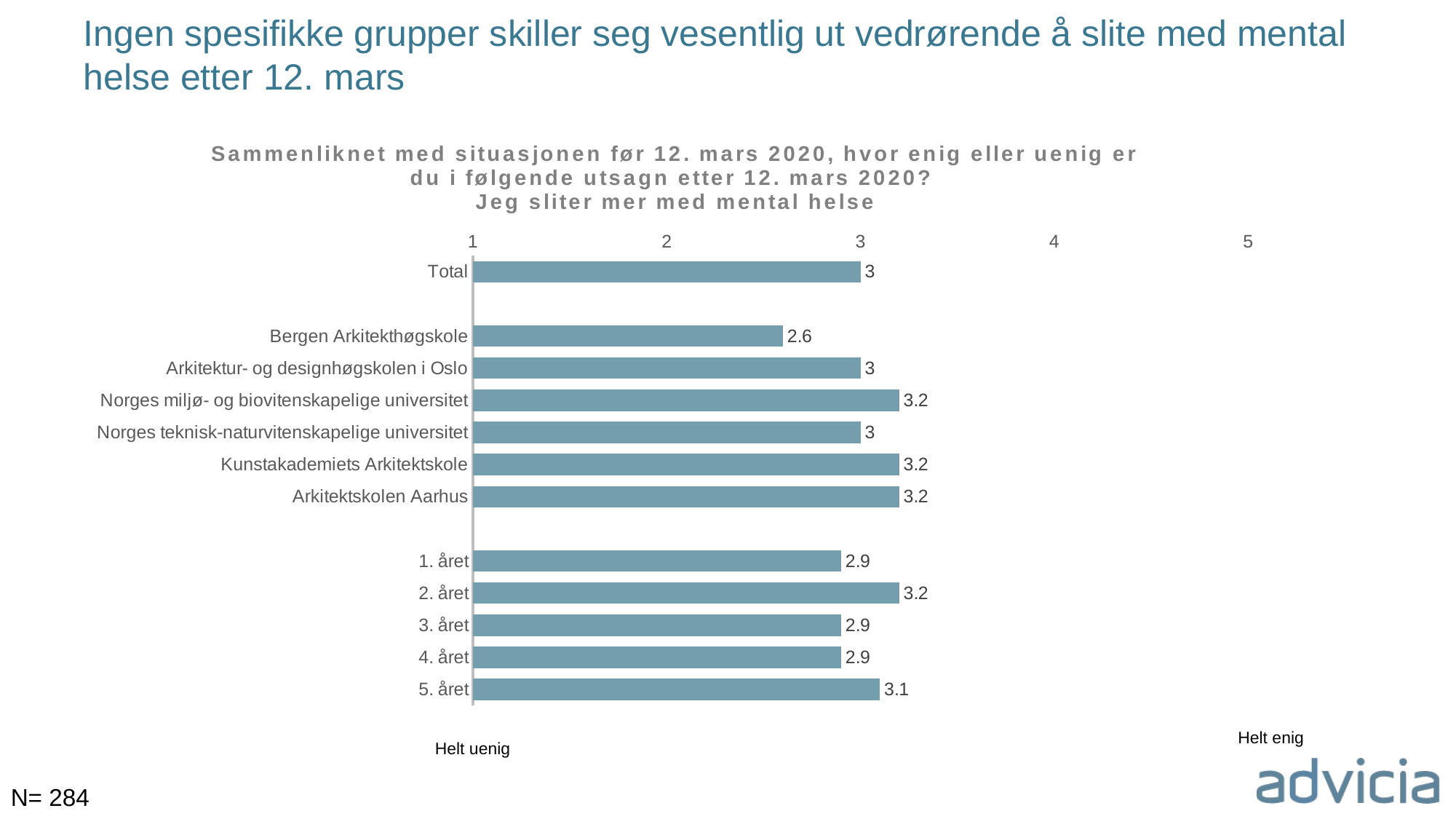
Is the value for Arkitektskolen Aarhus greater or less than 4? less Which category has the lowest value? Bergen Arkitekthøgskole What label appears at the left end of the scale below the chart? Helt uenig What is the value for Norges miljø- og biovitenskapelige universitet? 3.2 What is the value for 5. året? 3.1 What kind of chart is shown on the slide? bar chart What is the value for Bergen Arkitekthøgskole? 2.6 What is the difference between the values for Norges miljø- og biovitenskapelige universitet and Bergen Arkitekthøgskole? 0.6 How many categories are plotted in the chart? 12 Which is larger, the value for 2. året or the value for 1. året? 2. året What is the value for Total? 3 Is the value for Total greater or less than 2? greater